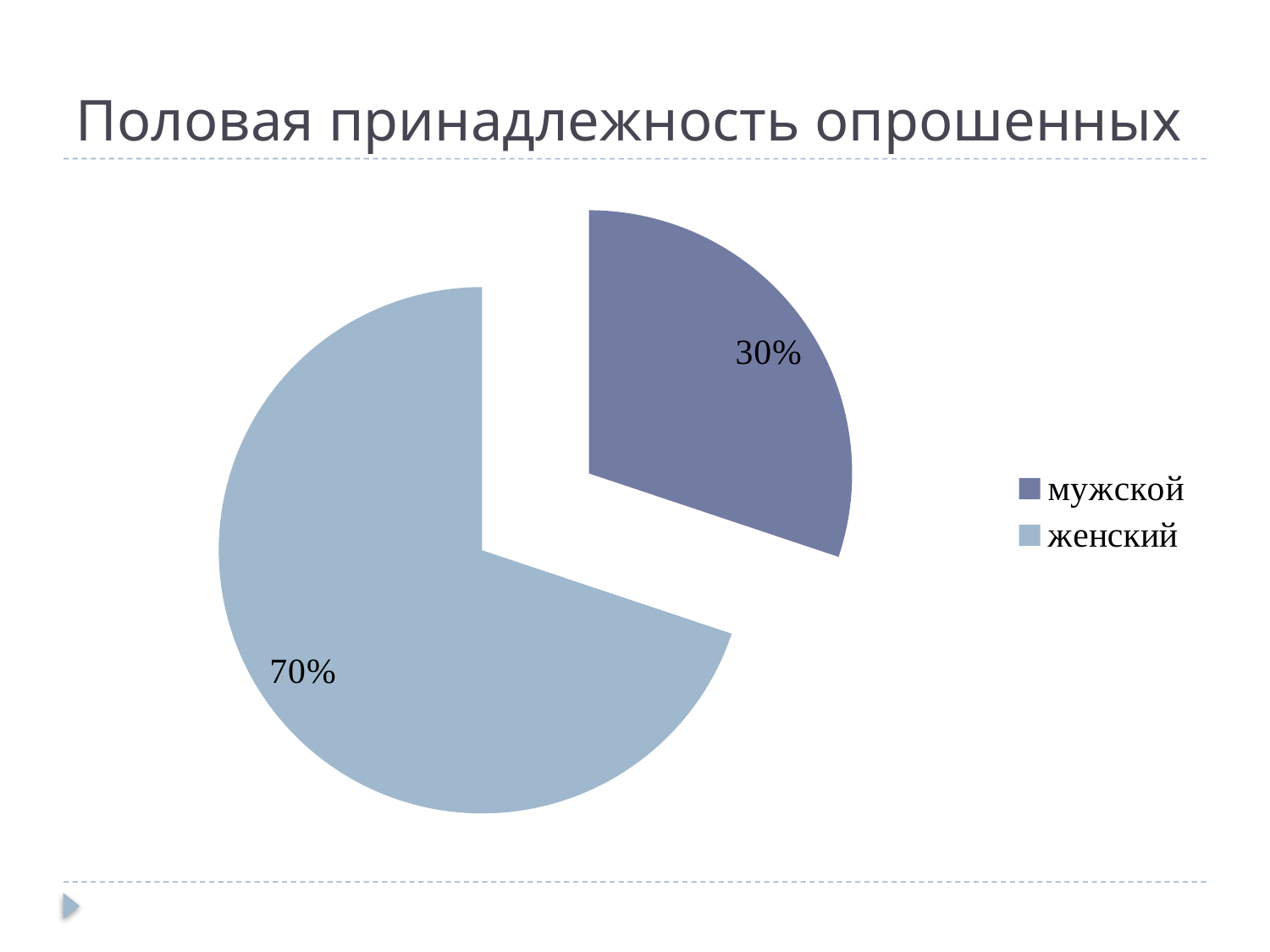
Which category has the smallest slice of the pie? мужской What is the difference in percentage points between the 'женский' and 'мужской' slices? 40% What share of the pie does the 'женский' slice represent? 70% Which category is shown in the darker blue-purple colour? мужской How many categories does the pie chart show? 2 Which category has the largest slice of the pie? женский What kind of chart is shown on the slide? Pie chart Which is larger, the 'мужской' slice or the 'женский' slice? женский What share of the pie does the 'мужской' slice represent? 30% What is the title of the slide? Половая принадлежность опрошенных